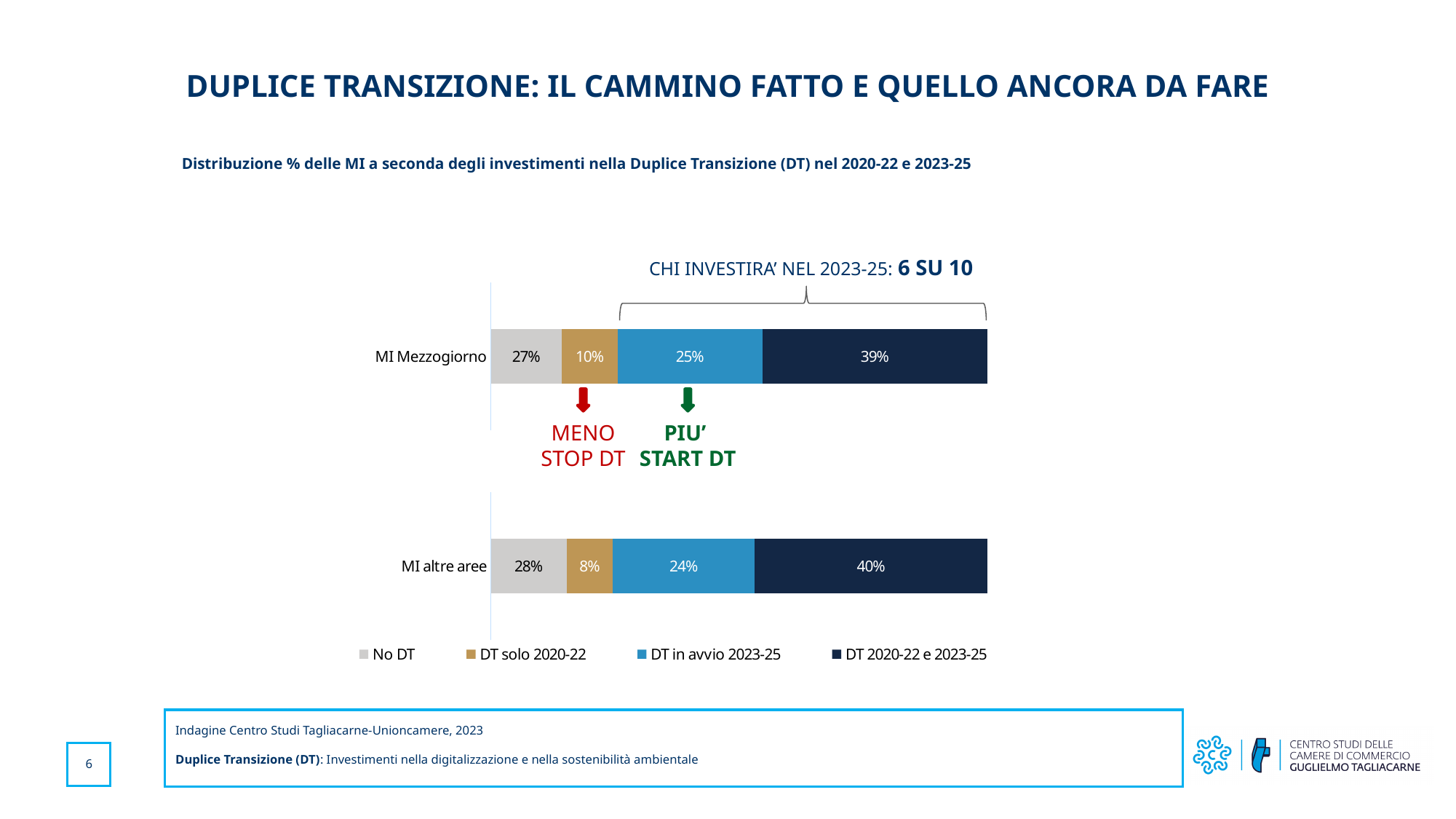
What kind of chart is shown on the slide? Stacked bar chart What is the difference between 'DT solo 2020-22' for MI Mezzogiorno and for MI altre aree? 2 percentage points Which is larger: 'DT in avvio 2023-25' for MI Mezzogiorno or for MI altre aree? MI Mezzogiorno What is the value of 'DT in avvio 2023-25' for MI altre aree? 24% What is the value of 'DT 2020-22 e 2023-25' for MI altre aree? 40% What is the total of the stacked bar for MI Mezzogiorno? 101% What is the value of 'No DT' for MI Mezzogiorno? 27% How many series does the legend list? 4 Which series has the highest value for MI Mezzogiorno? DT 2020-22 e 2023-25 What is the value of 'DT solo 2020-22' for MI Mezzogiorno? 10% How many categories (bars) are shown in the chart? 2 Which series has the lowest value for MI altre aree? DT solo 2020-22